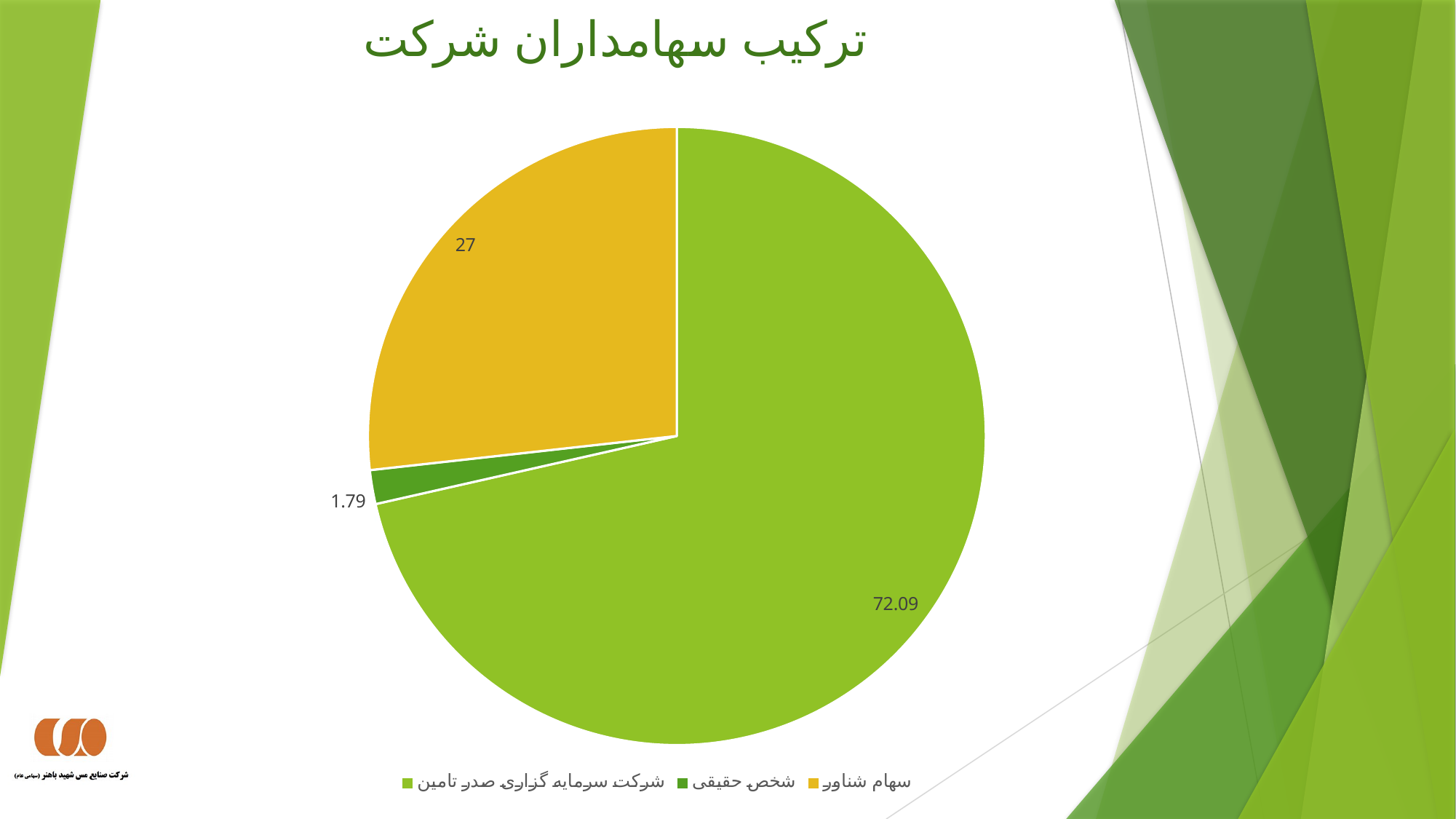
Which category has the largest slice of the pie? شرکت سرمایه گذاری صدر تامین What is the difference between the values for شرکت سرمایه گذاری صدر تامین and سهام شناور? 45.09 What type of chart is shown on the slide? pie chart How many slices does the pie chart have? 3 Which category has the smallest slice of the pie? شخص حقیقی What value is shown for شخص حقیقی? 1.79 How many entries does the legend list? 3 What is the title of the chart? ترکیب سهامداران شرکت What value is shown for سهام شناور? 27 What value is shown for شرکت سرمایه گذاری صدر تامین? 72.09 Which is larger, the value for سهام شناور or the value for شخص حقیقی? سهام شناور What colour is the slice for سهام شناور? yellow